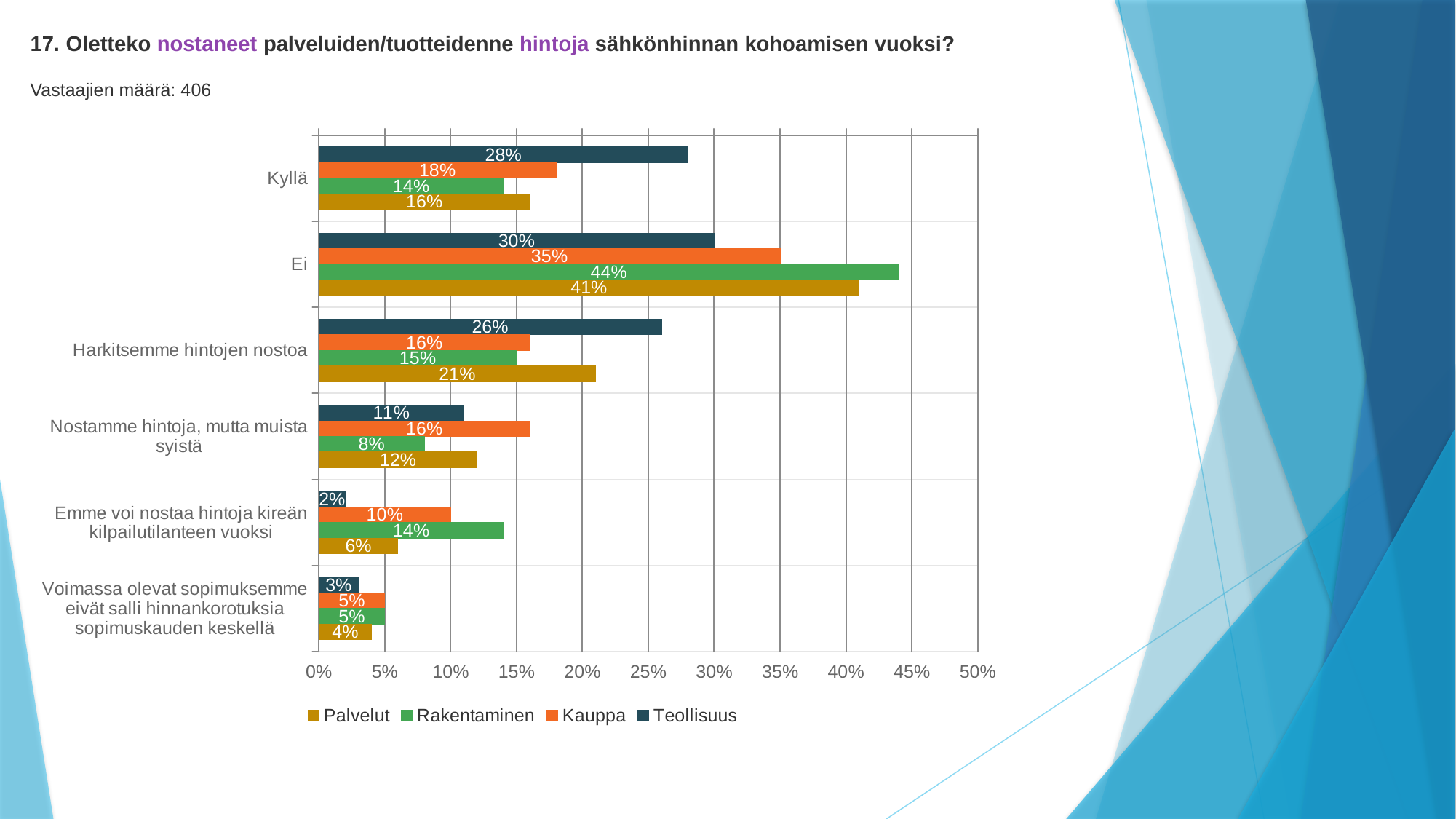
What is the value for Kauppa in the Nostamme hintoja, mutta muista syistä category? 16% Which series has the highest value in the Ei category? Rakentaminen Which series is shown in green in the legend? Rakentaminen How many categories are shown on the chart? 6 Which series has the lowest value in the Emme voi nostaa hintoja kireän kilpailutilanteen vuoksi category? Teollisuus What is the value for Teollisuus in the Kyllä category? 28% How many series does the legend list? 4 What is the value for Rakentaminen in the Ei category? 44% In the Harkitsemme hintojen nostoa category, which is larger: Teollisuus or Palvelut? Teollisuus What is the value for Palvelut in the Harkitsemme hintojen nostoa category? 21% What is the difference between the Teollisuus and Kauppa values in the Kyllä category? 10% What kind of chart is shown on the slide? bar chart